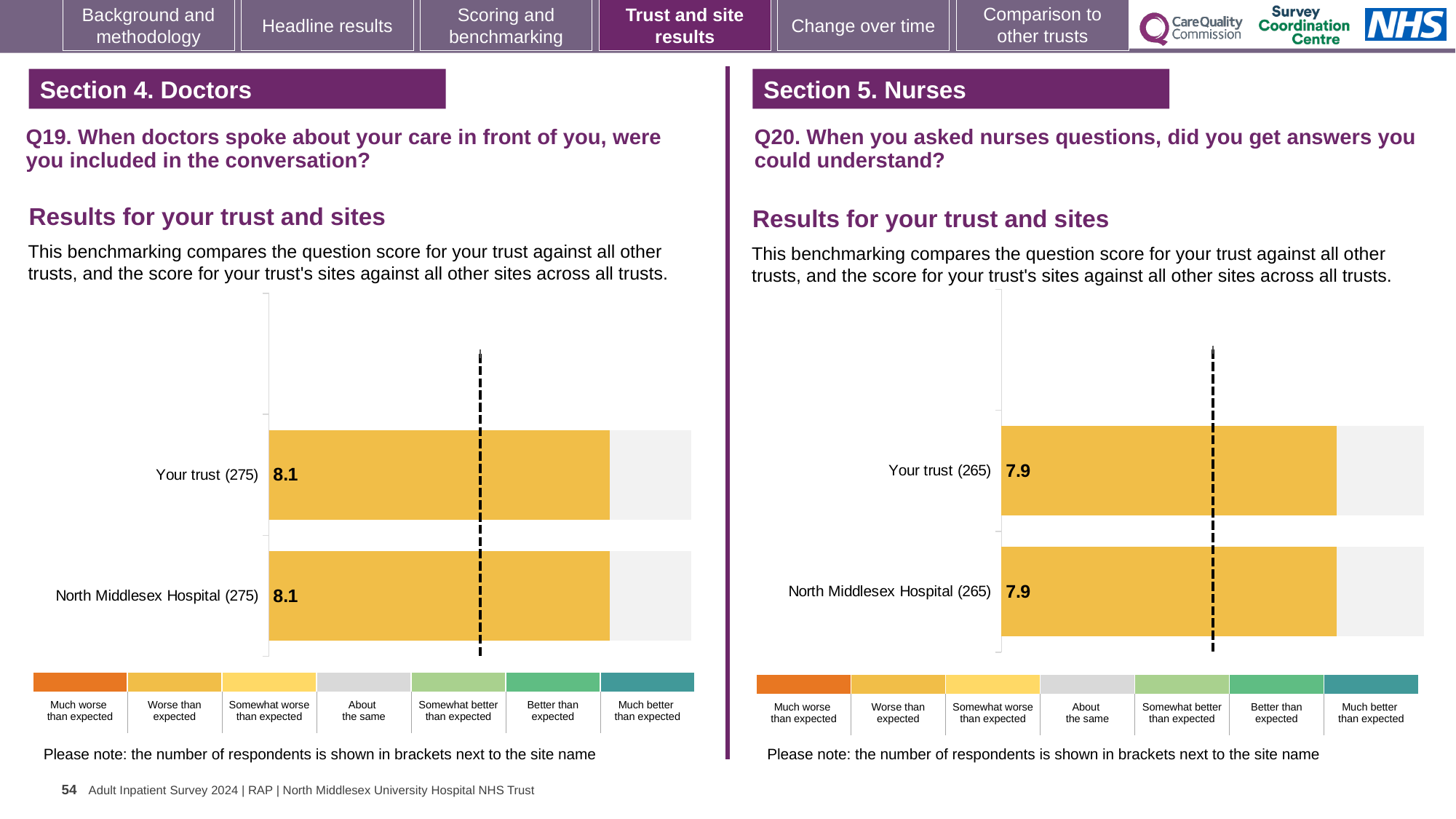
How many bars are plotted in the Q19 chart on the left? 2 In the Q20 chart on the right, how many respondents are shown in brackets next to North Middlesex Hospital? 265 In the Q20 chart on the right, what is the score for Your trust? 7.9 In the Q19 chart on the left, what is the score for North Middlesex Hospital? 8.1 In the Q19 chart on the left, what is the difference between the score for Your trust and the score for North Middlesex Hospital? 0 Is the score for Your trust in the Q19 chart on the left larger than the score for Your trust in the Q20 chart on the right? Yes How many bars are plotted in the Q20 chart on the right? 2 In the Q20 chart on the right, what is the difference between the score for Your trust and the score for North Middlesex Hospital? 0 In the Q19 chart on the left, what is the score for Your trust? 8.1 What type of chart is used for the Q19 results on the left? Bar chart In the Q19 chart on the left, how many respondents are shown in brackets next to Your trust? 275 In the Q20 chart on the right, what is the score for North Middlesex Hospital? 7.9